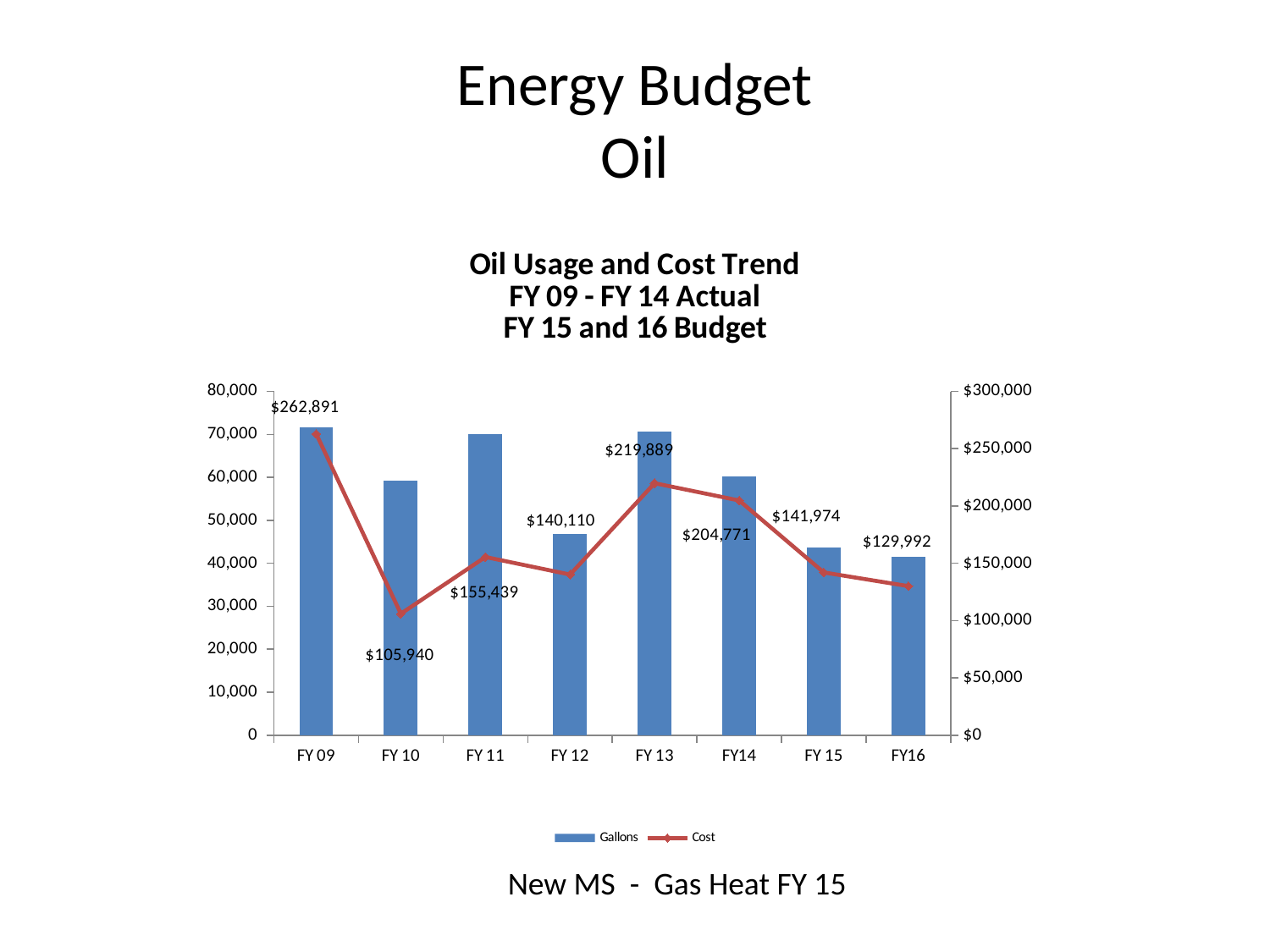
What is the Cost value for FY 13? $219,889 How many series does the legend list? 2 Is the Gallons value for FY 12 greater or less than 50,000? less Which is larger, the Cost for FY 13 or the Cost for FY14? FY 13 Which fiscal year has the highest Cost? FY 09 Is the Gallons value for FY 10 greater or less than 50,000? greater Which fiscal year has the lowest Cost? FY 10 What is the difference between the Cost for FY 09 and the Cost for FY 10? $156,951 How many fiscal years are shown on the x axis? 8 What is the Cost value for FY 09? $262,891 Does the Cost rise or fall from FY 13 to FY16? fall What is the Cost value for FY16? $129,992